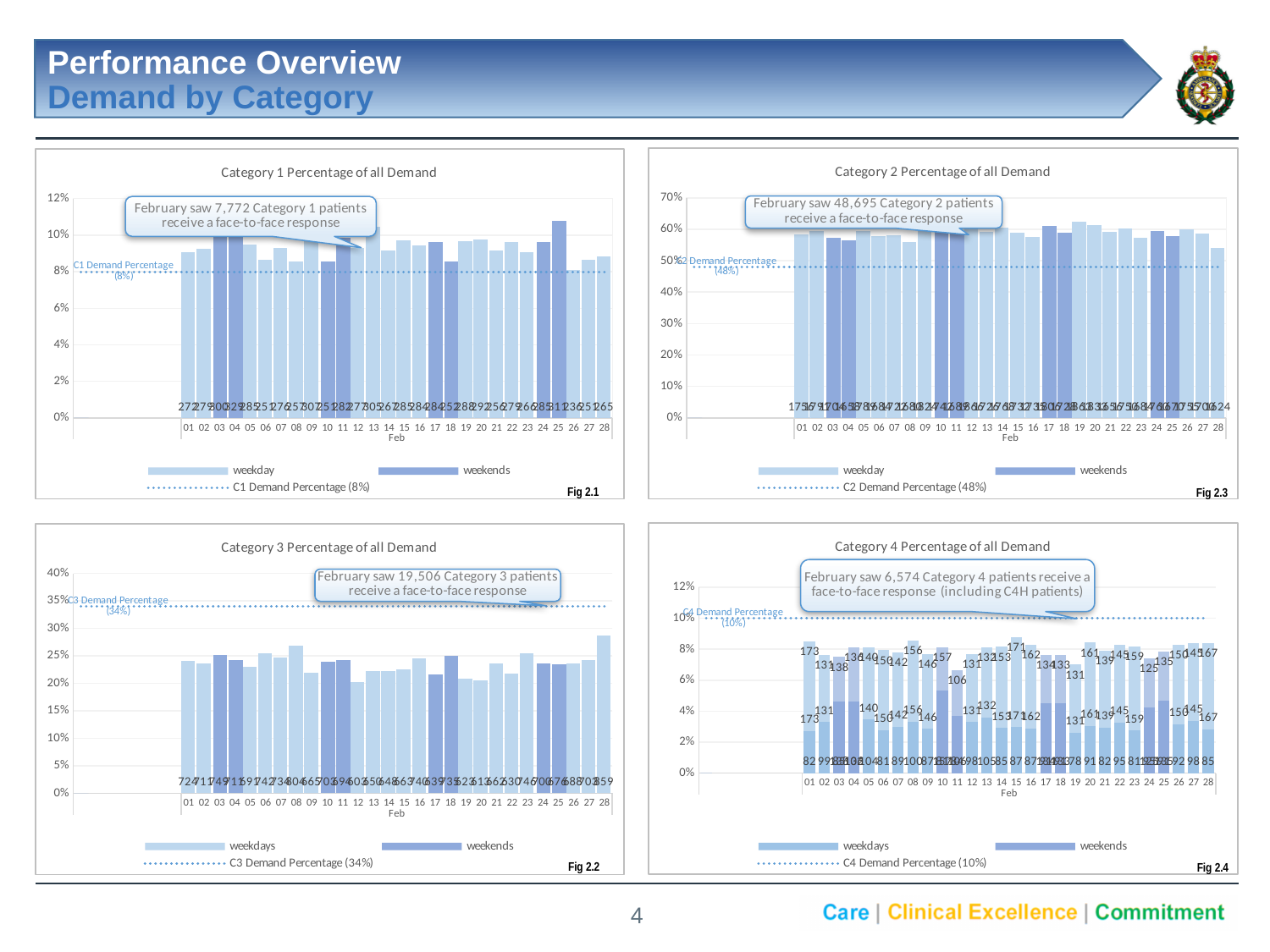
In the 'Category 3 Percentage of all Demand' chart, which day has the highest bar? 28 In the 'Category 2 Percentage of all Demand' chart, what value does the dotted C2 Demand Percentage line represent? 48% In the 'Category 1 Percentage of all Demand' chart, is the value for day 25 greater or less than 10%? greater What kind of chart is the 'Category 1 Percentage of all Demand' chart? Combination bar and line chart In the 'Category 3 Percentage of all Demand' chart, is the value for day 13 greater or less than 25%? less In the 'Category 4 Percentage of all Demand' chart, what value does the dotted C4 Demand Percentage line represent? 10% In the 'Category 1 Percentage of all Demand' chart, how many days of February are plotted on the x axis? 28 According to the callout on the 'Category 2 Percentage of all Demand' chart, how many Category 2 patients received a face-to-face response in February? 48,695 In the 'Category 1 Percentage of all Demand' chart, how many entries does the legend list? 3 According to the callout on the 'Category 3 Percentage of all Demand' chart, how many Category 3 patients received a face-to-face response in February? 19,506 In the 'Category 2 Percentage of all Demand' chart, is the value for day 01 greater or less than 50%? greater In the 'Category 1 Percentage of all Demand' chart, what value does the dotted C1 Demand Percentage line represent? 8%